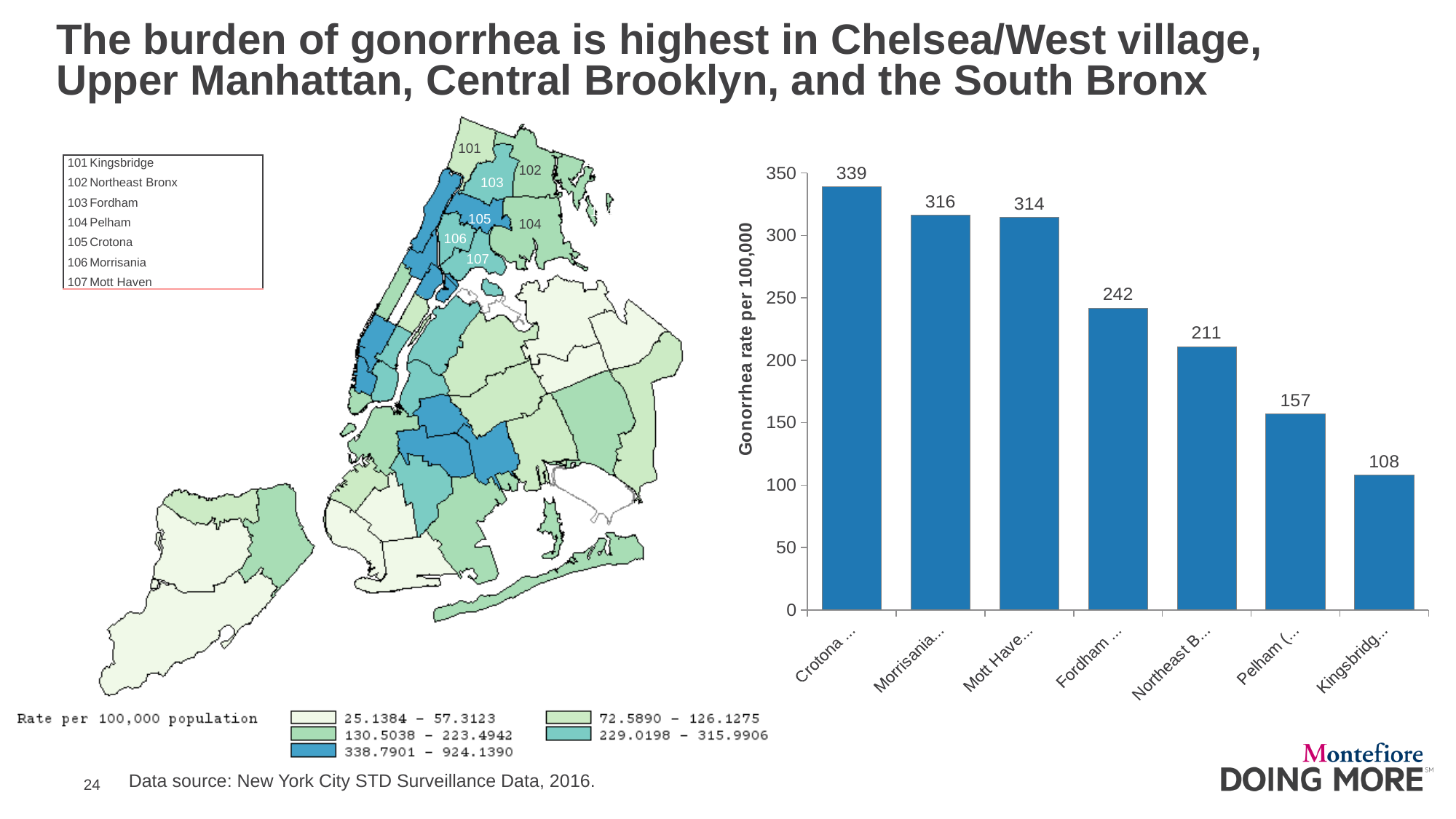
In the bar chart, what is the gonorrhea rate per 100,000 for Fordham? 242 In the bar chart, what is the gonorrhea rate per 100,000 for Pelham? 157 In the bar chart, what is the difference between the gonorrhea rates for Morrisania and Mott Haven? 2 What kind of chart is shown on the right side of the slide? Bar chart How many neighborhoods are shown in the bar chart? 7 In the bar chart, what is the gonorrhea rate per 100,000 for Kingsbridge? 108 In the bar chart, which neighborhood has the lowest gonorrhea rate? Kingsbridge In the bar chart, what is the gonorrhea rate per 100,000 for Crotona? 339 In the bar chart, which neighborhood has the highest gonorrhea rate? Crotona In the bar chart, do the gonorrhea rates rise or fall from left to right? Fall In the bar chart, which has a higher gonorrhea rate, Fordham or Northeast Bronx? Fordham In the bar chart, what is the difference between the gonorrhea rates for Crotona and Kingsbridge? 231